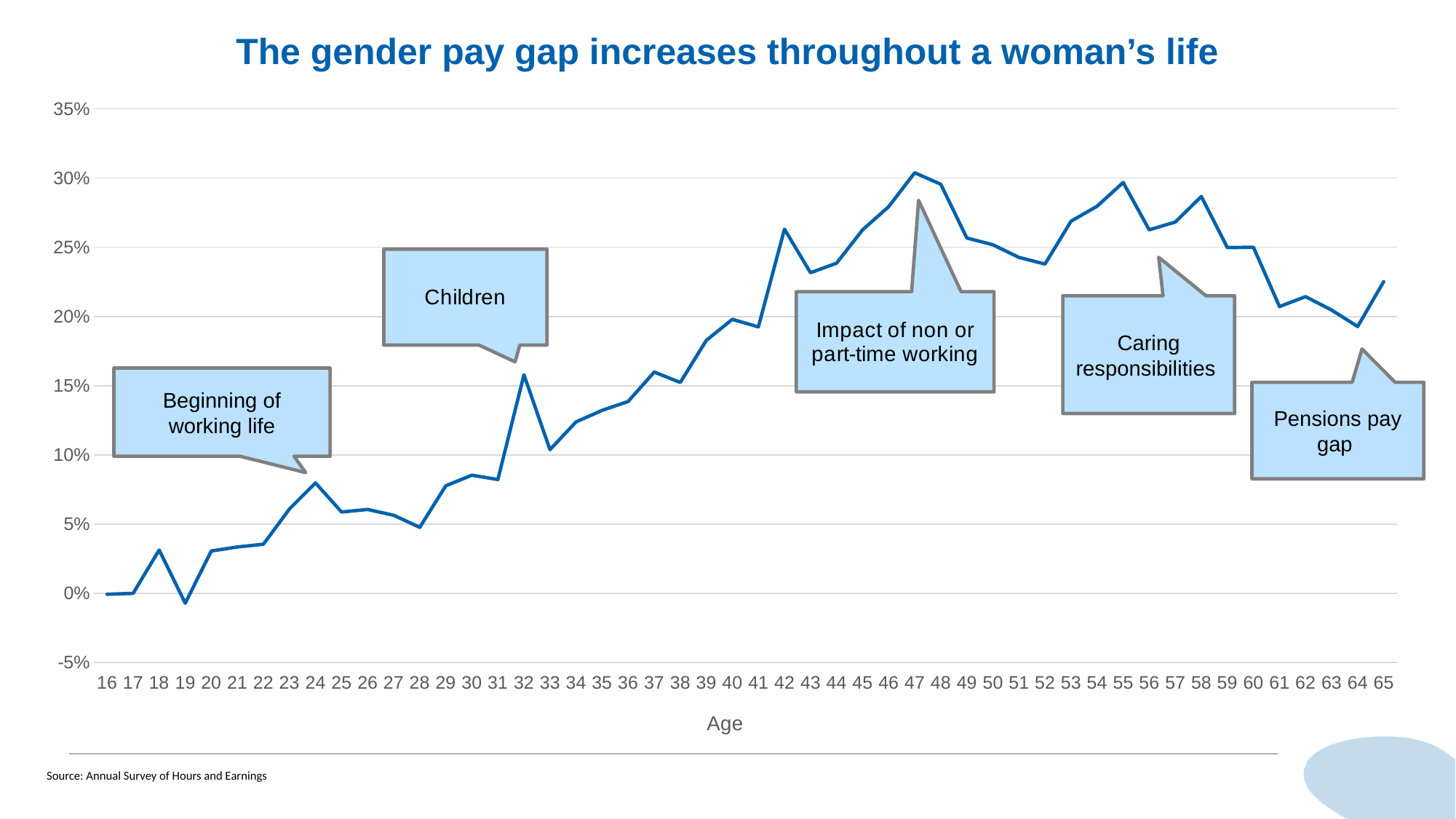
At which age is the gender pay gap lowest? 19 What is the label of the x axis? Age What is the title of the chart? The gender pay gap increases throughout a woman's life Overall, does the gender pay gap rise or fall as age increases from 16 to 65? rise Is the value at age 24 greater or less than 10%? less Is the value at age 65 greater or less than 20%? greater What kind of chart is shown on the slide? line chart How many ages are plotted along the x axis? 50 Is the value at age 47 greater or less than 25%? greater At which age is the gender pay gap highest? 47 Which age has the larger gender pay gap, 24 or 28? 24